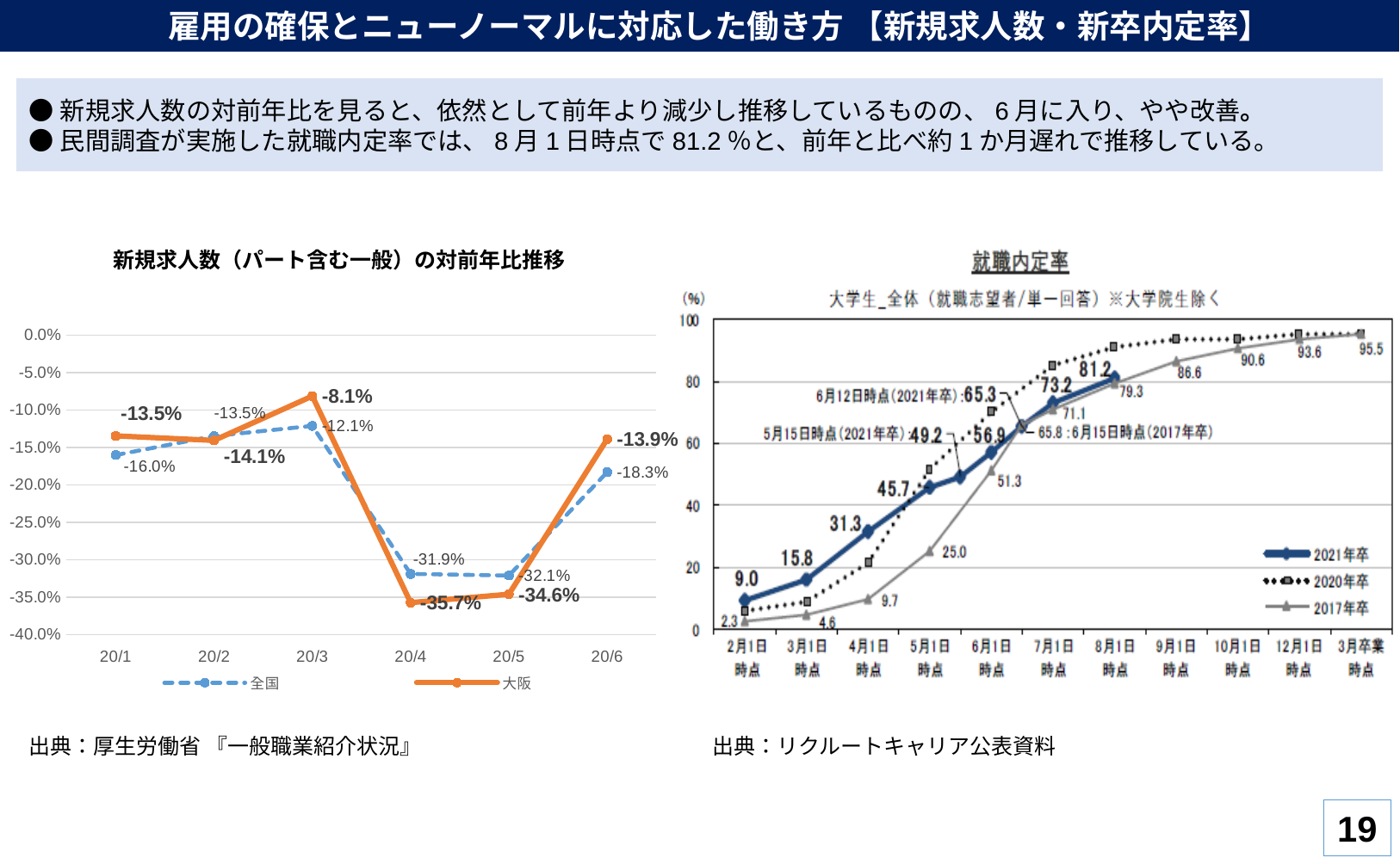
In the left chart (新規求人数の対前年比推移), at which month is the 全国 value lowest? 20/5 In the left chart (新規求人数の対前年比推移), what is the value for 大阪 at 20/6? -13.9% In the left chart (新規求人数の対前年比推移), what is the difference between the 全国 and 大阪 values at 20/6? 4.4 percentage points In the left chart (新規求人数の対前年比推移), at which month is the 大阪 value highest? 20/3 In the left chart (新規求人数の対前年比推移), what is the value for 大阪 at 20/4? -35.7% In the left chart (新規求人数の対前年比推移), which series has the higher value at 20/4, 全国 or 大阪? 全国 In the right chart (就職内定率), what is the difference between the 2021年卒 and 2017年卒 values at 6月1日時点? 5.6 In the left chart (新規求人数の対前年比推移), how many series does the legend list? 2 In the left chart (新規求人数の対前年比推移), what is the value for 全国 at 20/1? -16.0% In the right chart (就職内定率), what is the value for 2017年卒 at 3月卒業時点? 95.5 In the right chart (就職内定率), how many series does the legend list? 3 In the right chart (就職内定率), what is the value for 2021年卒 at 8月1日時点? 81.2